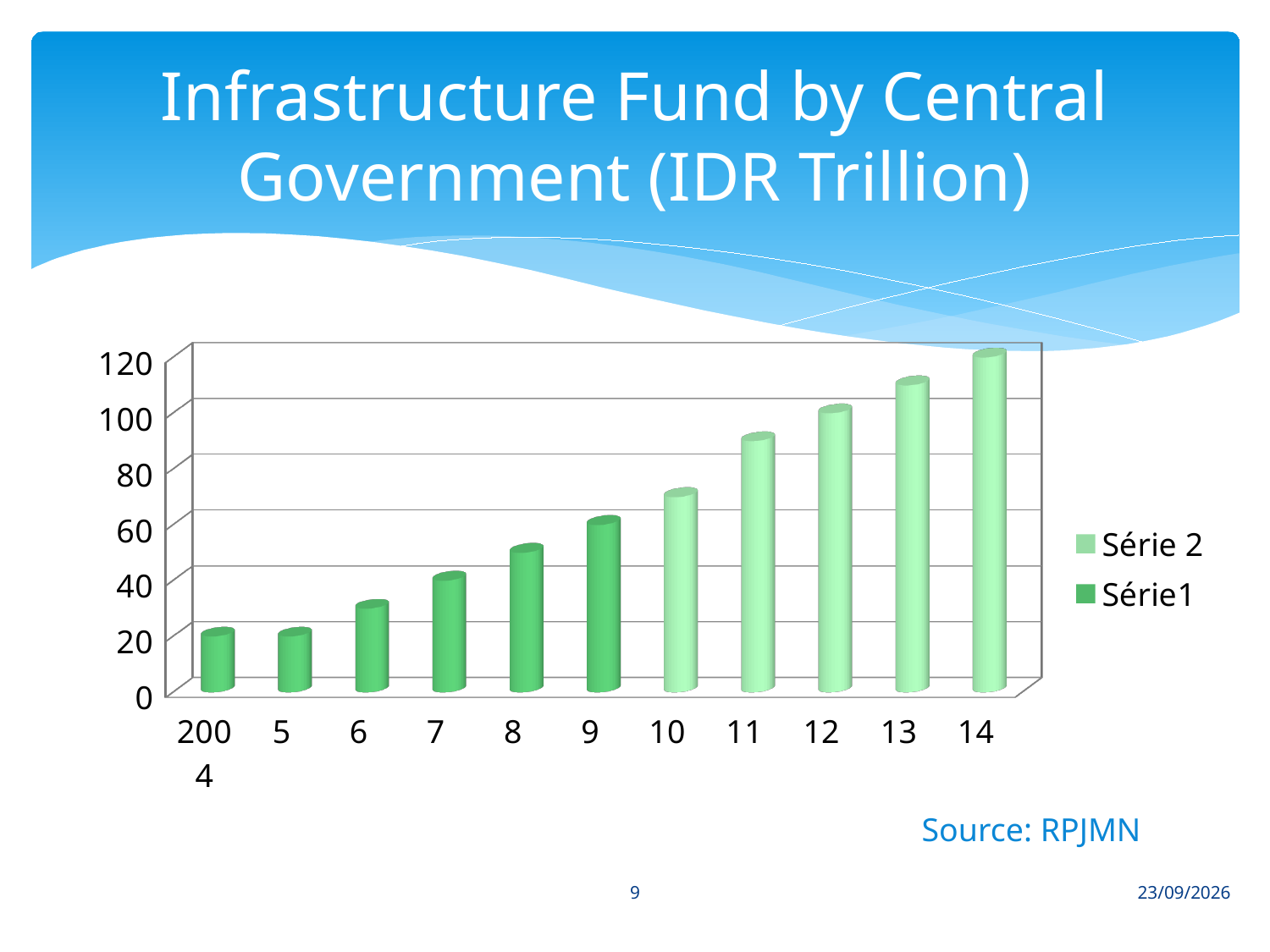
Is the value for 11 greater or less than 80? greater What is the title of the chart on the slide? Infrastructure Fund by Central Government (IDR Trillion) What are the two legend entries of the chart? Série 2 and Série1 How many series does the legend list? 2 Is the value for 6 greater or less than 40? less How many years (categories) are shown on the x axis? 11 Is the value for 8 greater or less than 60? less Which year has the highest value in the chart? 14 What kind of chart is shown on the slide? bar chart Do the values generally rise or fall from 2004 to 14? rise Which is larger, the value for 10 or the value for 12? 12